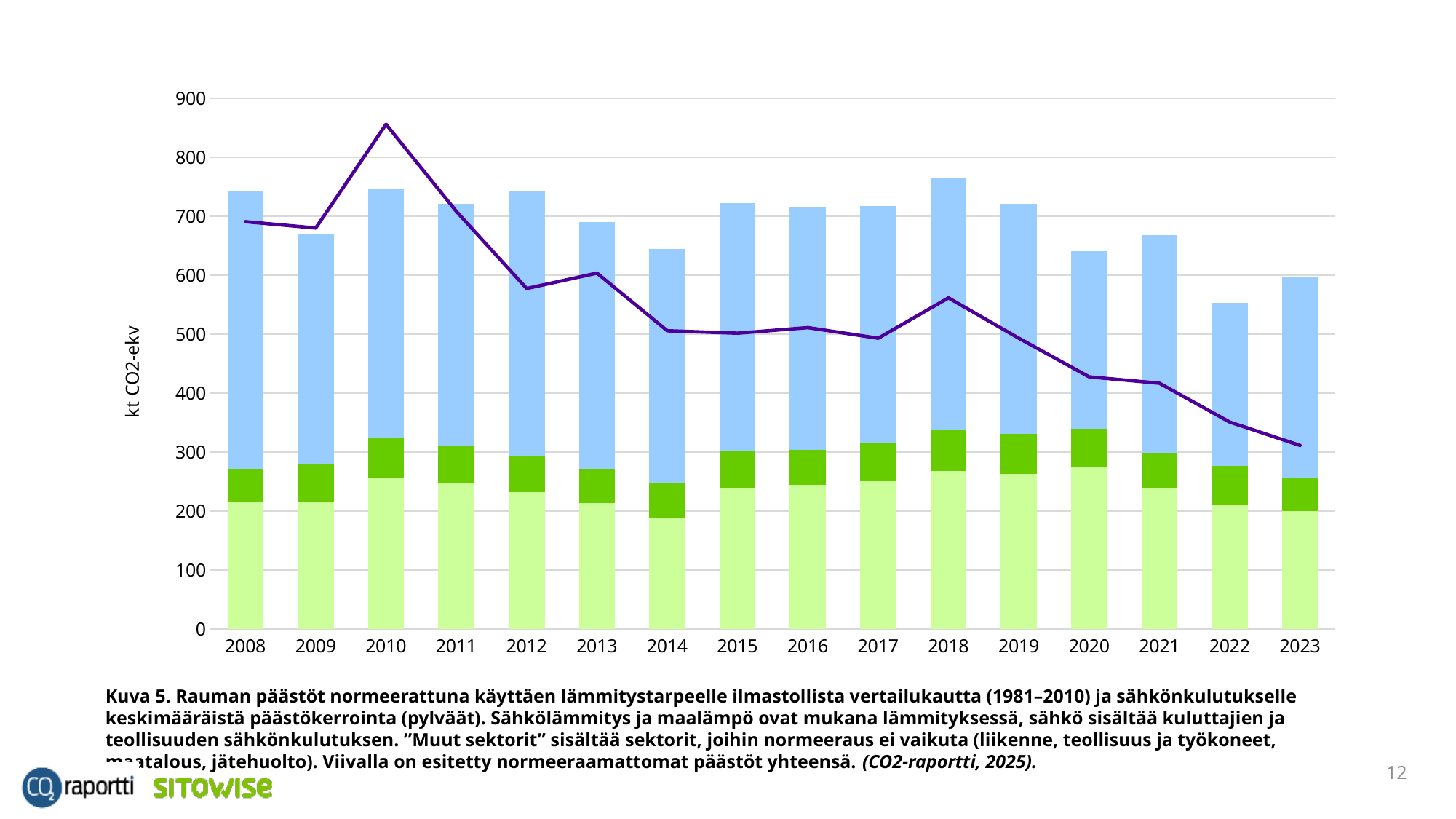
In which year does the purple line reach its highest value? 2010 Is the value of the purple line in 2010 greater or less than 800? greater What is the label on the vertical axis of the chart? kt CO2-ekv Which year has the shortest stacked bar? 2022 Is the purple line value higher in 2008 or in 2023? 2008 In which year does the purple line reach its lowest value? 2023 Does the purple line overall rise or fall from 2010 to 2023? fall How many coloured segments does each stacked bar have? 3 Is the total height of the stacked bar for 2022 greater or less than 600? less How many years are shown on the x axis of the chart? 16 Is the value of the purple line in 2020 greater or less than 400? greater What kind of chart is shown on the slide? A stacked bar chart with a line